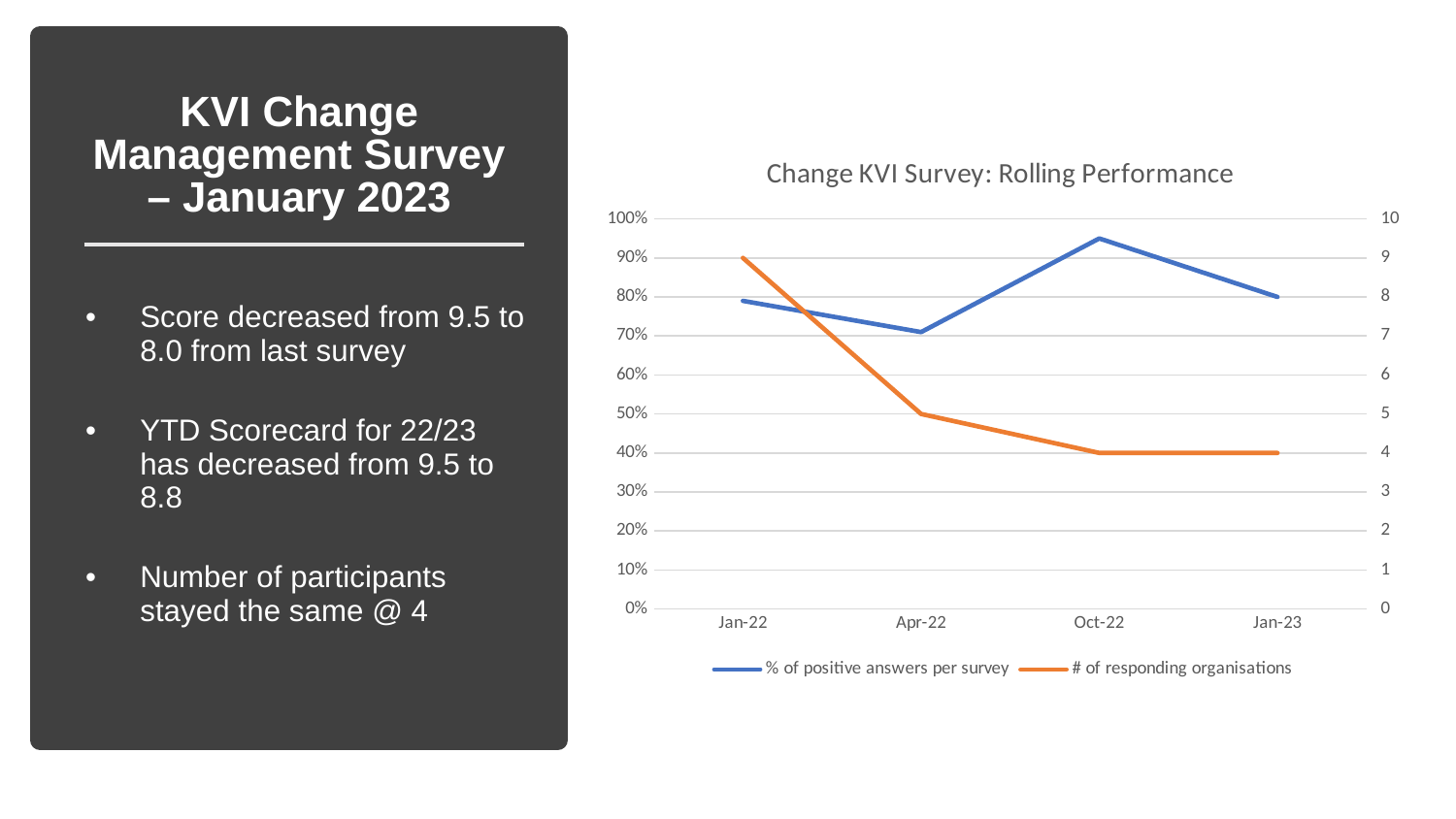
What kind of chart is shown on the slide? Line chart What is the number of responding organisations for Jan-22? 9 What is the number of responding organisations for Apr-22? 5 What is the difference in the number of responding organisations between Jan-22 and Jan-23? 5 Does the number of responding organisations rise or fall from Jan-22 to Oct-22? Fall What is the % of positive answers per survey for Jan-23? 80% What is the number of responding organisations for Jan-23? 4 Which survey period has the highest % of positive answers per survey? Oct-22 How many series does the legend list? 2 How many survey periods are plotted along the x axis? 4 Is the % of positive answers per survey for Oct-22 greater or less than 90%? greater Which survey period has the lowest % of positive answers per survey? Apr-22